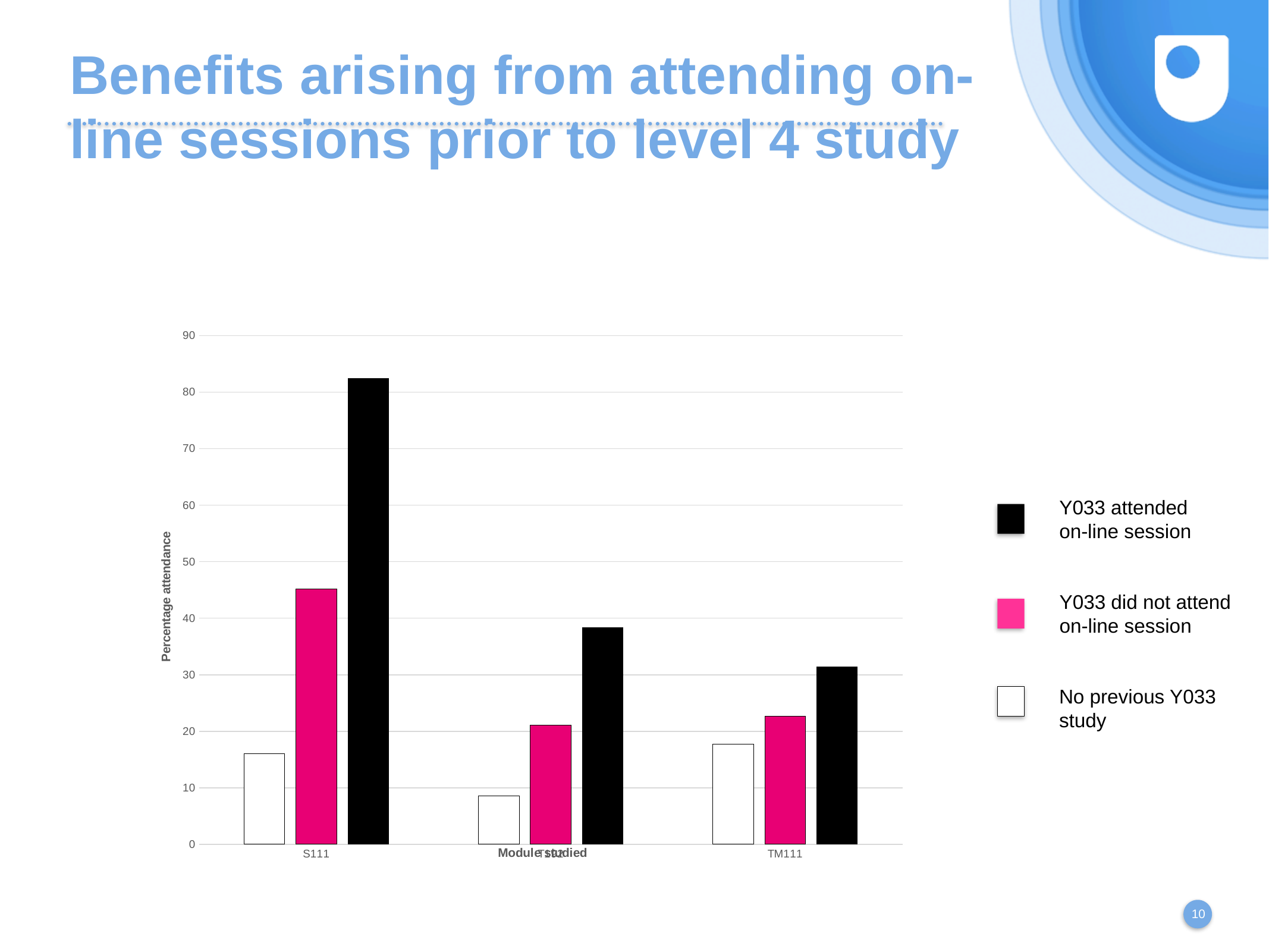
Is the value for 'Y033 attended on-line session' at TM111 greater or less than 40? less Is the value for 'Y033 did not attend on-line session' at S111 greater or less than 40? greater Do the values for 'Y033 attended on-line session' rise or fall from S111 to TM111 along the x axis? fall At TM111, which is larger: 'No previous Y033 study' or 'Y033 did not attend on-line session'? Y033 did not attend on-line session How many module categories are shown on the x axis? 3 What is the title of the vertical axis? Percentage attendance Is the value for 'Y033 attended on-line session' at S111 greater or less than 80? greater Which is larger: the 'Y033 attended on-line session' value for S111 or for TM111? S111 How many series does the legend list? 3 What kind of chart is shown on the slide? bar chart Which module has the highest value for 'Y033 attended on-line session'? S111